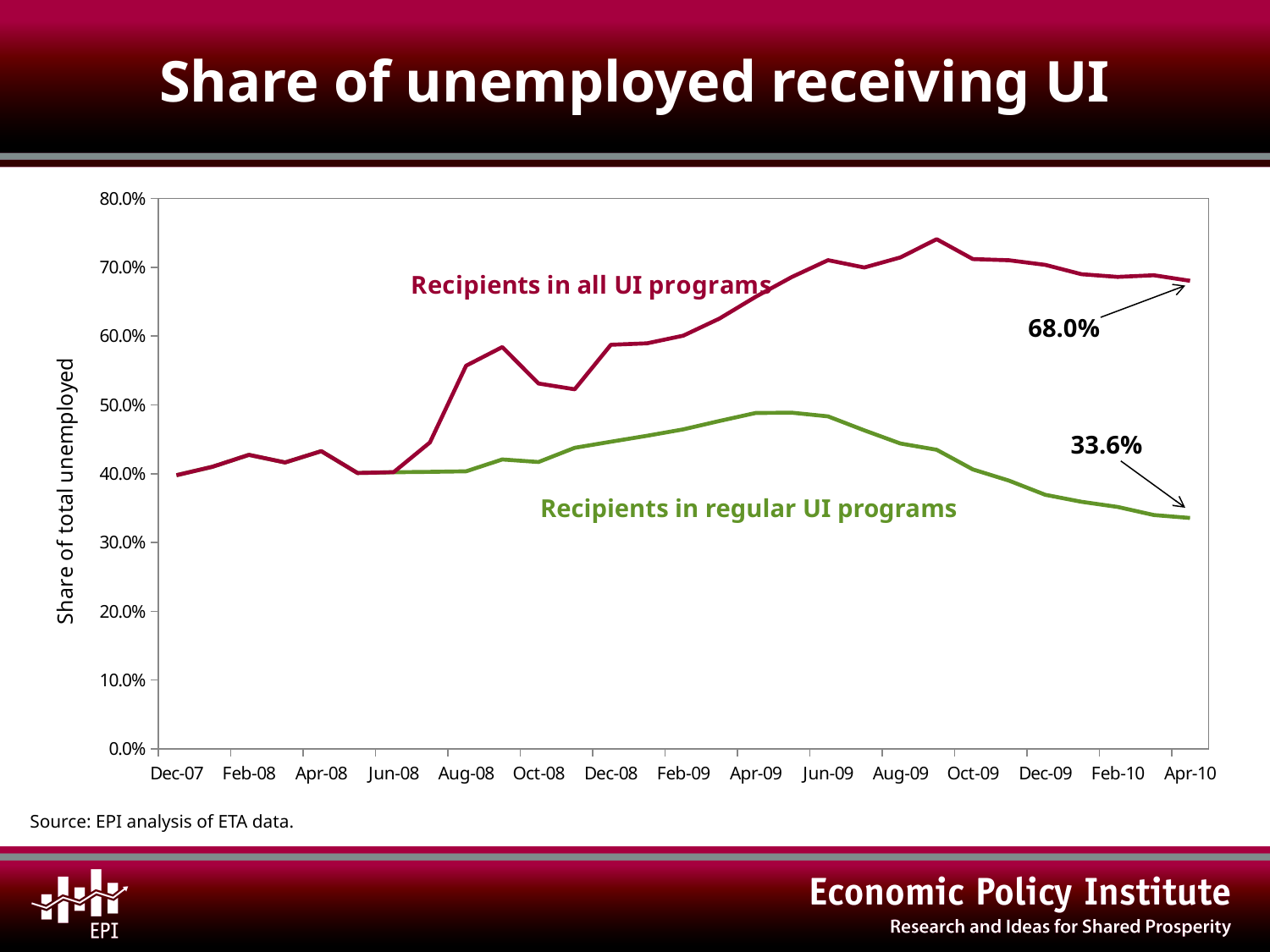
Is the value for recipients in all UI programs in Dec-08 greater or less than 50.0%? greater Does the share of recipients in regular UI programs rise or fall between Apr-09 and Apr-10? Fall Is the value for recipients in all UI programs in Aug-09 greater or less than 70.0%? greater What is the title of the y axis? Share of total unemployed In Apr-10, how many percentage points higher is the share for all UI programs than for regular UI programs? 34.4 percentage points What is the share of unemployed receiving benefits in regular UI programs in Apr-10? 33.6% What is the share of unemployed receiving benefits in all UI programs in Apr-10? 68.0% How many series are plotted on the chart? 2 Is the value for recipients in regular UI programs in Dec-09 greater or less than 40.0%? less What kind of chart is shown on the slide? Line chart In Apr-10, which series has the higher value: recipients in all UI programs or recipients in regular UI programs? Recipients in all UI programs How many month labels are shown on the x axis? 15